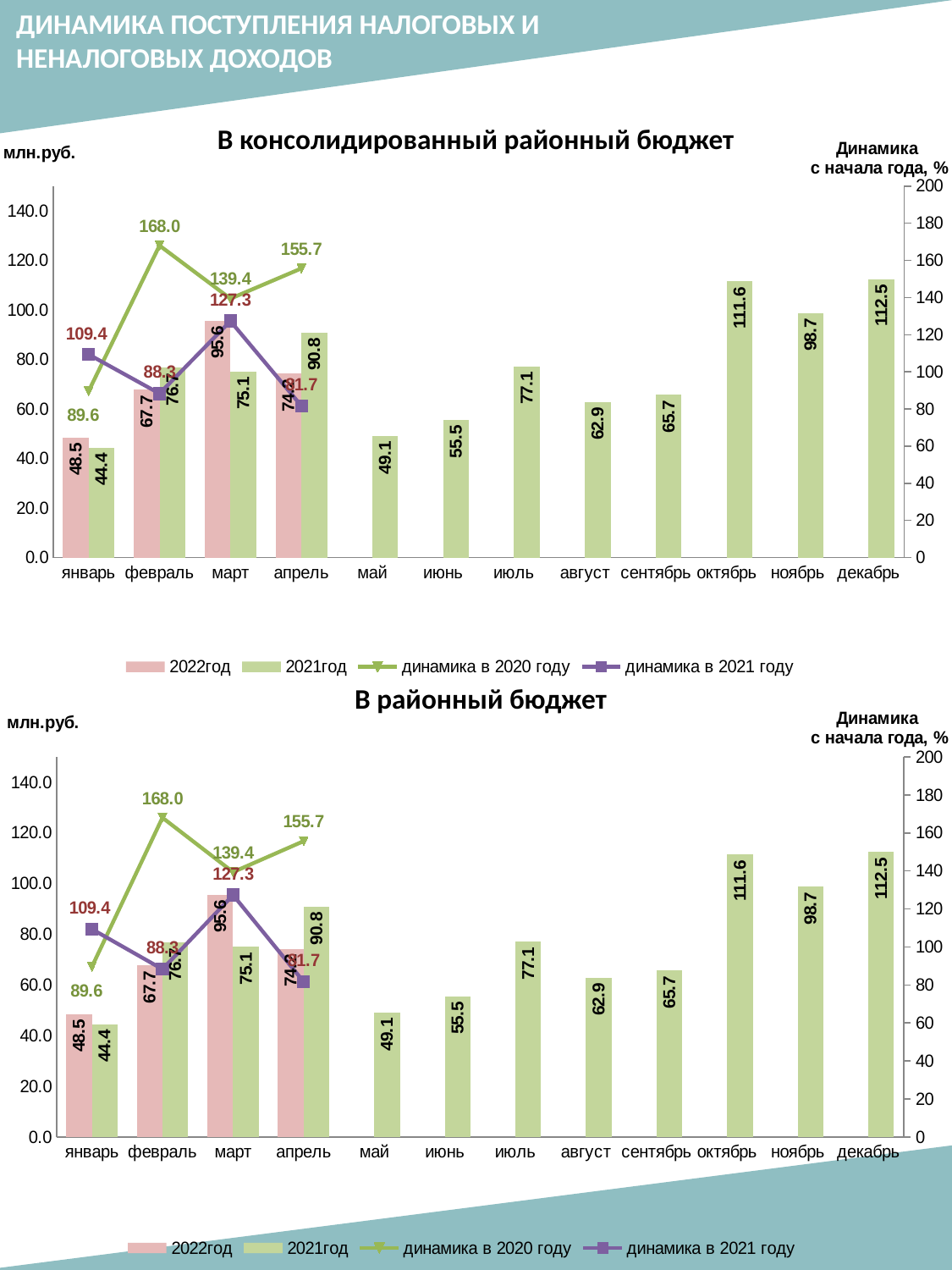
On the bottom chart 'В районный бюджет', how many months are shown on the x axis? 12 On the top chart 'В консолидированный районный бюджет', what is the value of the 2022год bar for март? 95.6 On the bottom chart 'В районный бюджет', what is the value of the 'динамика в 2021 году' line for март? 127.3 On the top chart 'В консолидированный районный бюджет', what is the value of the 'динамика в 2020 году' line for февраль? 168.0 On the bottom chart 'В районный бюджет', how many series does the legend list? 4 On the bottom chart 'В районный бюджет', what is the difference between the 'динамика в 2020 году' values for февраль and январь? 78.4 On the top chart 'В консолидированный районный бюджет', which month has the highest 2021год bar? декабрь On the top chart 'В консолидированный районный бюджет', which is larger for январь: the 2022год bar or the 2021год bar? 2022год On the top chart 'В консолидированный районный бюджет', what is the difference between the 2021год bars for октябрь and ноябрь? 12.9 On the top chart 'В консолидированный районный бюджет', which month has the lowest 2021год bar? январь On the bottom chart 'В районный бюджет', what is the value of the 2021год bar for июль? 77.1 On the top chart 'В консолидированный районный бюджет', what is the value of the 2021год bar for декабрь? 112.5